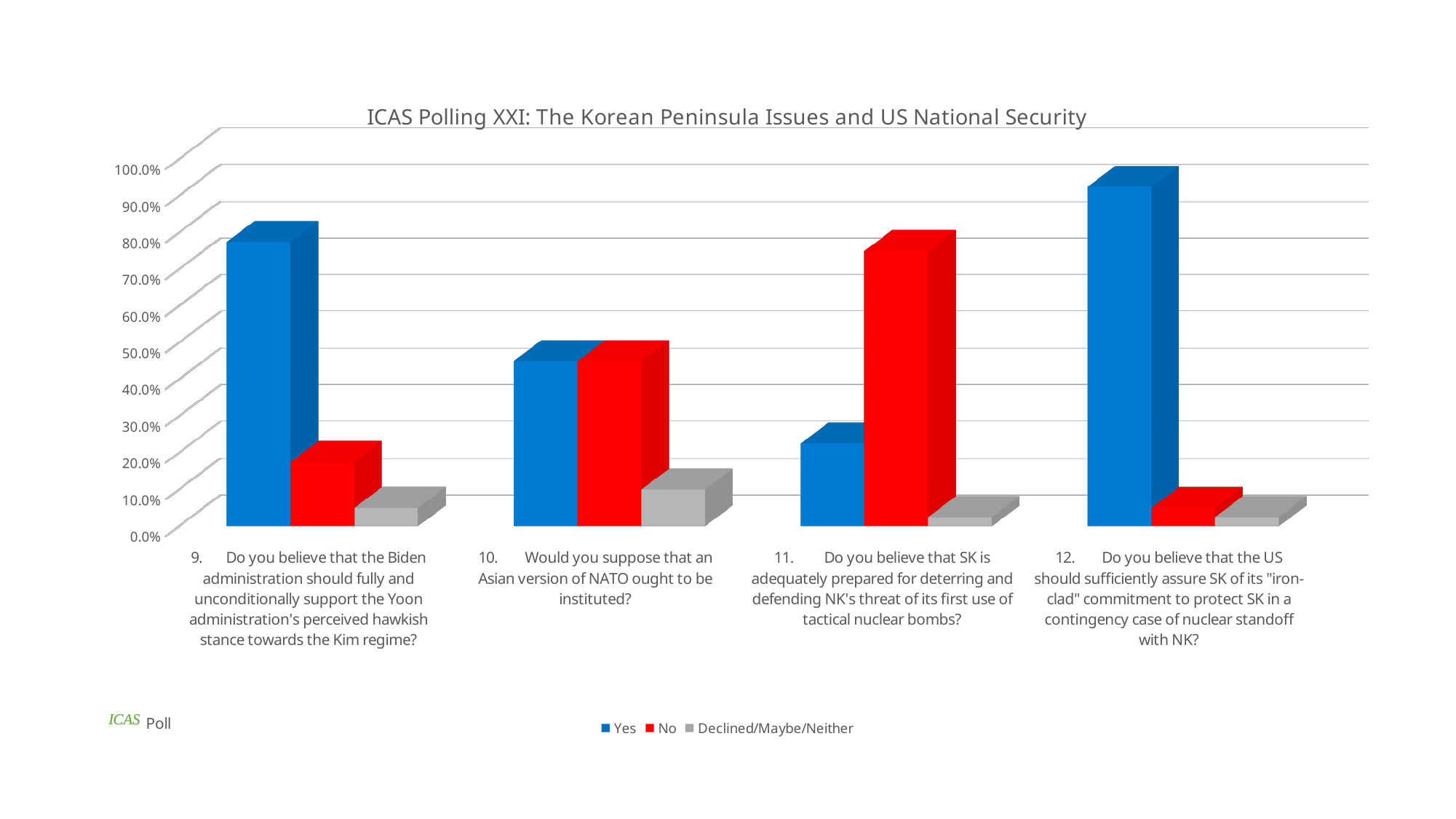
How many series does the legend list? 3 Which poll question has the highest "Yes" value? 12. Do you believe that the US should sufficiently assure SK of its "iron-clad" commitment to protect SK in a contingency case of nuclear standoff with NK? For question 11 (SK adequately prepared for NK's tactical nuclear threat), which is larger, the "Yes" value or the "No" value? No Which colour represents the "No" responses in the chart? Red How many poll questions (categories) are plotted on the x axis? 4 Is the "No" value for question 11 (SK adequately prepared for NK's tactical nuclear threat) greater or less than 70.0%? greater Is the "Yes" value for question 11 (SK adequately prepared for NK's tactical nuclear threat) greater or less than 30.0%? less What kind of chart is shown on the slide? Bar chart Which poll question has the lowest "Yes" value? 11. Do you believe that SK is adequately prepared for deterring and defending NK's threat of its first use of tactical nuclear bombs? Is the "Yes" value for question 12 (US "iron-clad" commitment to protect SK) greater or less than 80.0%? greater What is the title of the chart? ICAS Polling XXI: The Korean Peninsula Issues and US National Security